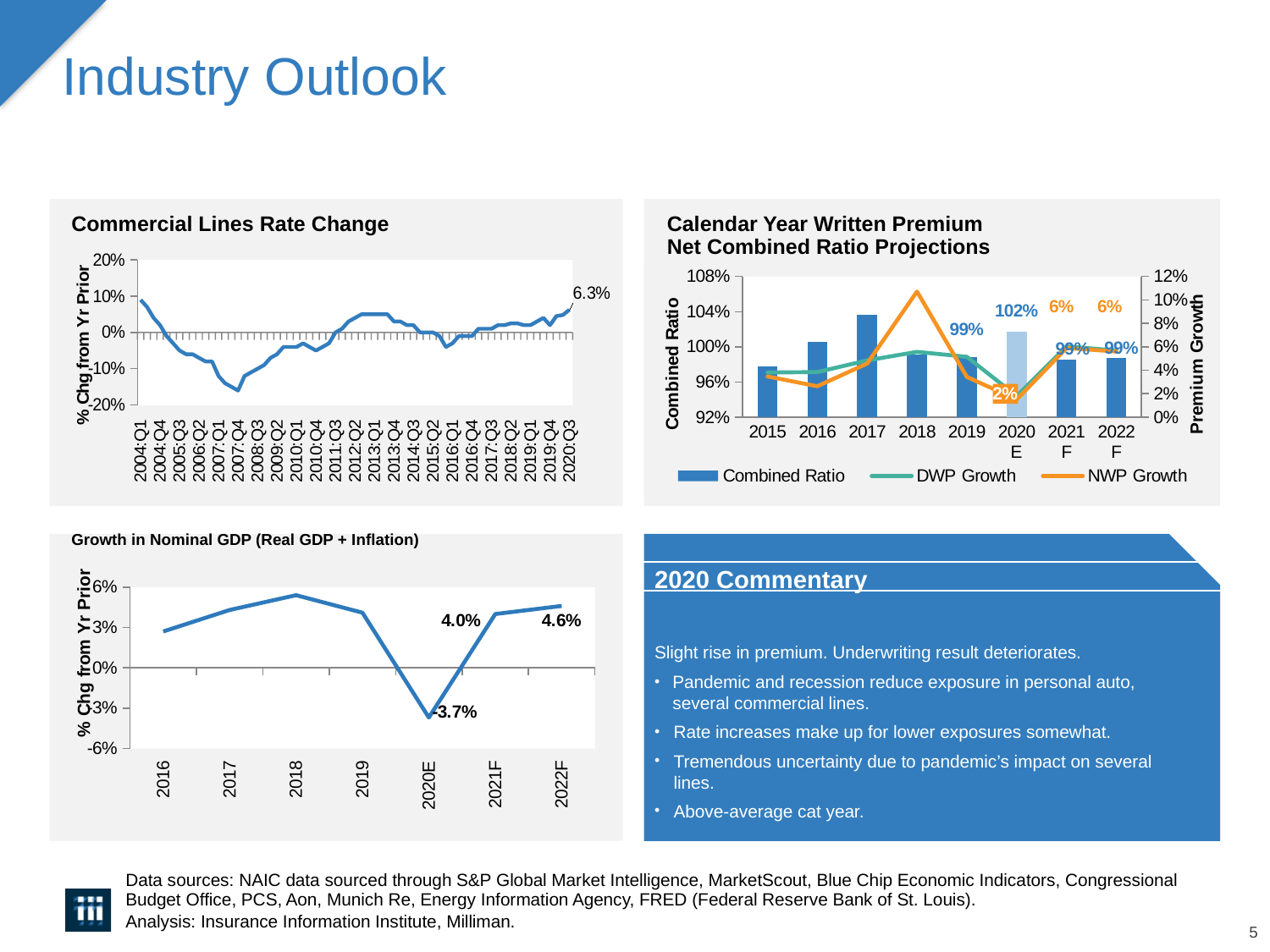
In the Calendar Year Written Premium Net Combined Ratio Projections chart, what is the NWP Growth value for 2020E? 2% In the Growth in Nominal GDP chart, what is the value for 2020E? -3.7% What kind of chart is the Commercial Lines Rate Change chart? Line chart In the Growth in Nominal GDP chart, which is larger, the value for 2021F or 2022F? 2022F In the Calendar Year Written Premium Net Combined Ratio Projections chart, what is the combined ratio for 2020E? 102% In the Calendar Year Written Premium Net Combined Ratio Projections chart, how many series does the legend list? 3 In the Calendar Year Written Premium Net Combined Ratio Projections chart, is the combined ratio for 2015 greater or less than 100%? less In the Calendar Year Written Premium Net Combined Ratio Projections chart, what is the difference between the combined ratio for 2020E and for 2019? 3 percentage points In the Commercial Lines Rate Change chart, what is the value labeled at the final point, 2020:Q3? 6.3% In the Growth in Nominal GDP chart, which year has the lowest value? 2020E In the Commercial Lines Rate Change chart, is the value for 2007:Q4 greater or less than -10%? less In the Growth in Nominal GDP chart, how many years are plotted on the x axis? 7